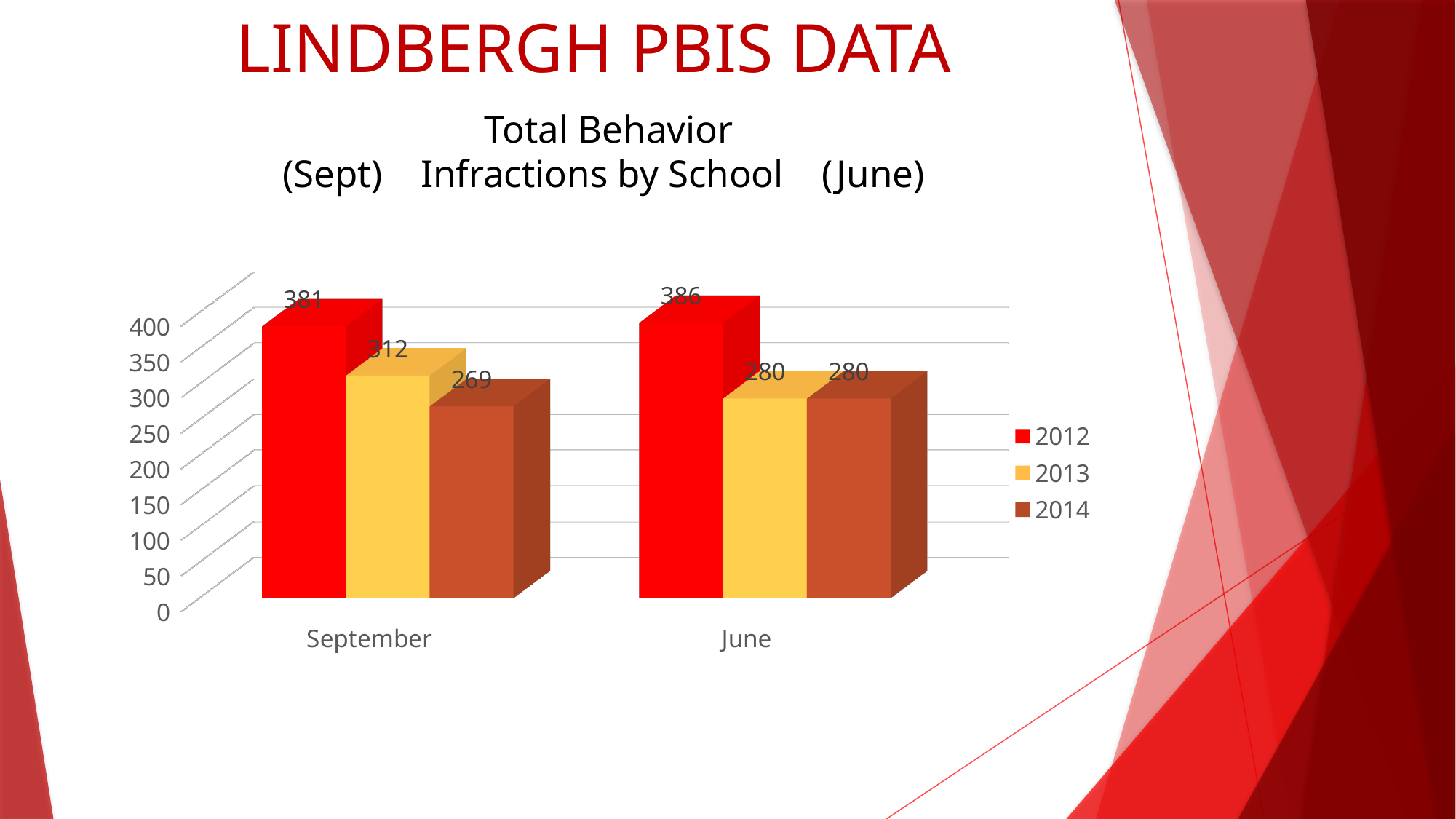
How many categories are shown on the x axis? 2 What is the value for 2012 in September? 381 What is the difference between the 2012 and 2013 values in September? 69 Which year has the lowest value in September? 2014 How many series does the legend list? 3 Which colour represents the 2014 series in the legend? brown Which year has the highest value in June? 2012 What is the difference between the 2012 values for June and September? 5 What is the value for 2013 in June? 280 Which is larger, the 2013 value in September or the 2013 value in June? September What kind of chart is shown on the slide? bar chart What is the value for 2014 in September? 269